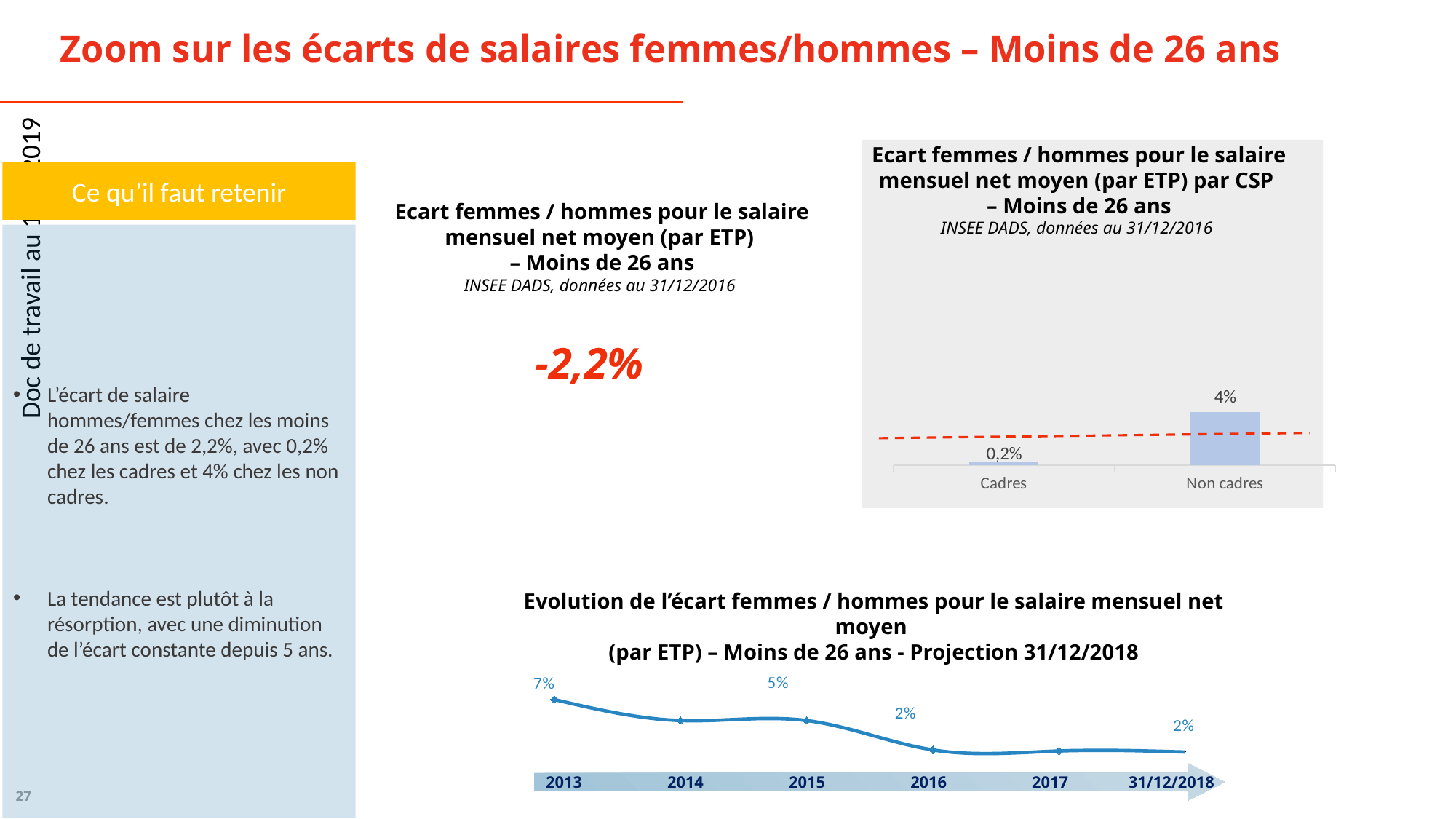
In the line chart at the bottom of the slide, what is the value for 31/12/2018? 2% In the line chart at the bottom of the slide, what is the value for 2016? 2% In the bar chart by CSP (top right), what is the difference between the Non cadres value and the Cadres value? 3,8% In the bar chart 'Ecart femmes / hommes pour le salaire mensuel net moyen (par ETP) par CSP – Moins de 26 ans', what is the value for Non cadres? 4% In the bar chart by CSP (top right), which category has the higher value, Cadres or Non cadres? Non cadres In the line chart at the bottom of the slide, what is the value for 2015? 5% What kind of chart is the chart by CSP in the top right of the slide? Bar chart How many data points are plotted in the line chart at the bottom of the slide? 6 In the bar chart 'Ecart femmes / hommes pour le salaire mensuel net moyen (par ETP) par CSP – Moins de 26 ans', what is the value for Cadres? 0,2% In the line chart at the bottom of the slide, do the values rise or fall from 2013 to 31/12/2018? Fall In the line chart 'Evolution de l'écart femmes / hommes pour le salaire mensuel net moyen (par ETP) – Moins de 26 ans - Projection 31/12/2018', what is the value for 2013? 7% How many categories are shown in the bar chart by CSP (top right)? 2